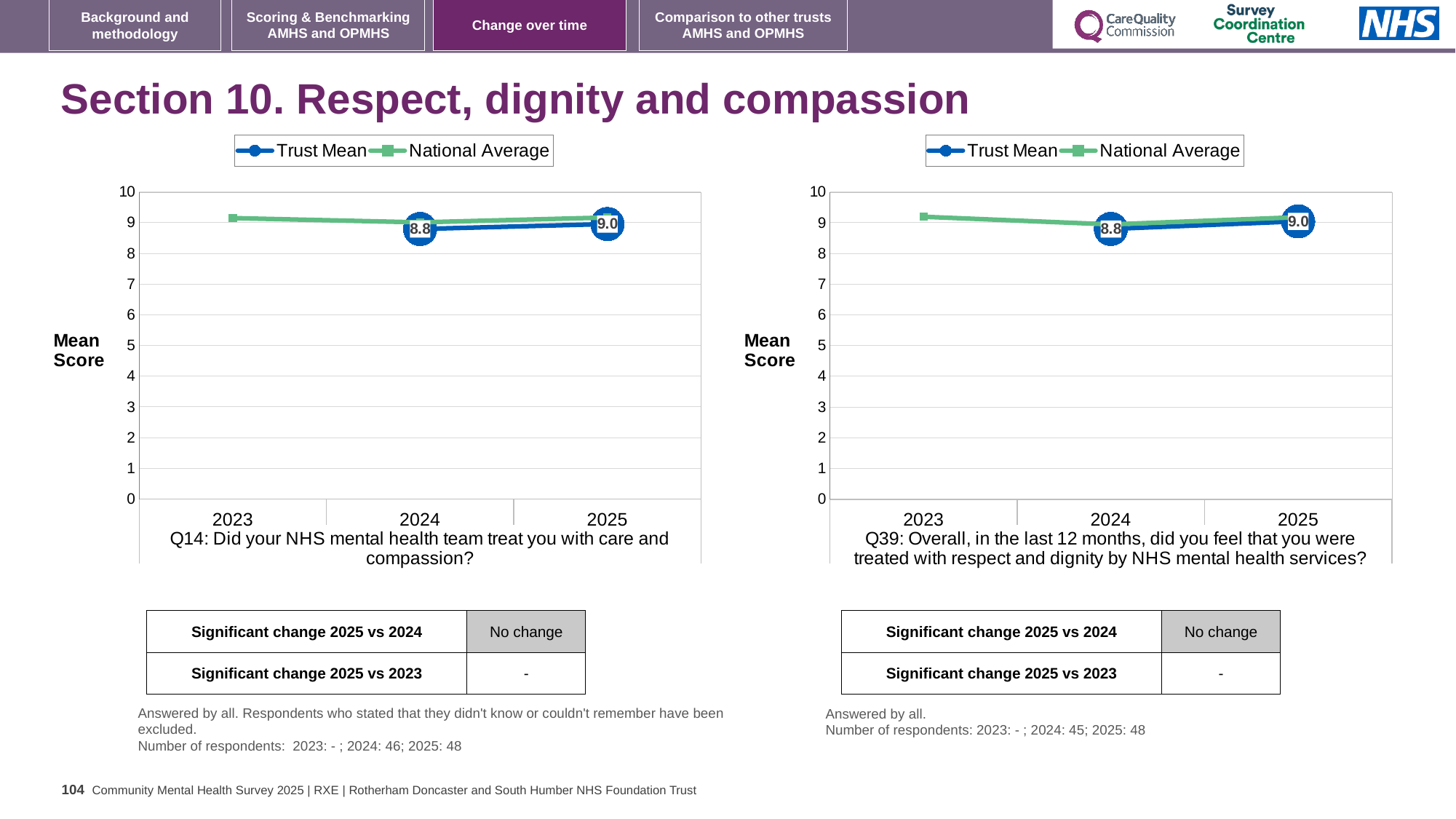
In the Q14 chart on the left, by how much did the Trust Mean change from 2024 to 2025? 0.2 In the Q39 chart on the right, did the Trust Mean rise or fall from 2024 to 2025? rise In the Q14 chart on the left, what is the Trust Mean for 2025? 9.0 What kind of chart is the Q14 chart on the left? line chart In the Q39 chart on the right, is the National Average for 2023 greater or less than 5? greater In the Q39 chart on the right, what is the Trust Mean for 2024? 8.8 In the Q39 chart on the right, what is the Trust Mean for 2025? 9.0 In the Q14 chart on the left, what is the Trust Mean for 2024? 8.8 How many years are shown on the x axis of the Q14 chart on the left? 3 In the Q14 chart on the left, which series is drawn in green? National Average How many series does the legend of the Q39 chart on the right list? 2 What is the label on the y axis of the Q39 chart on the right? Mean Score